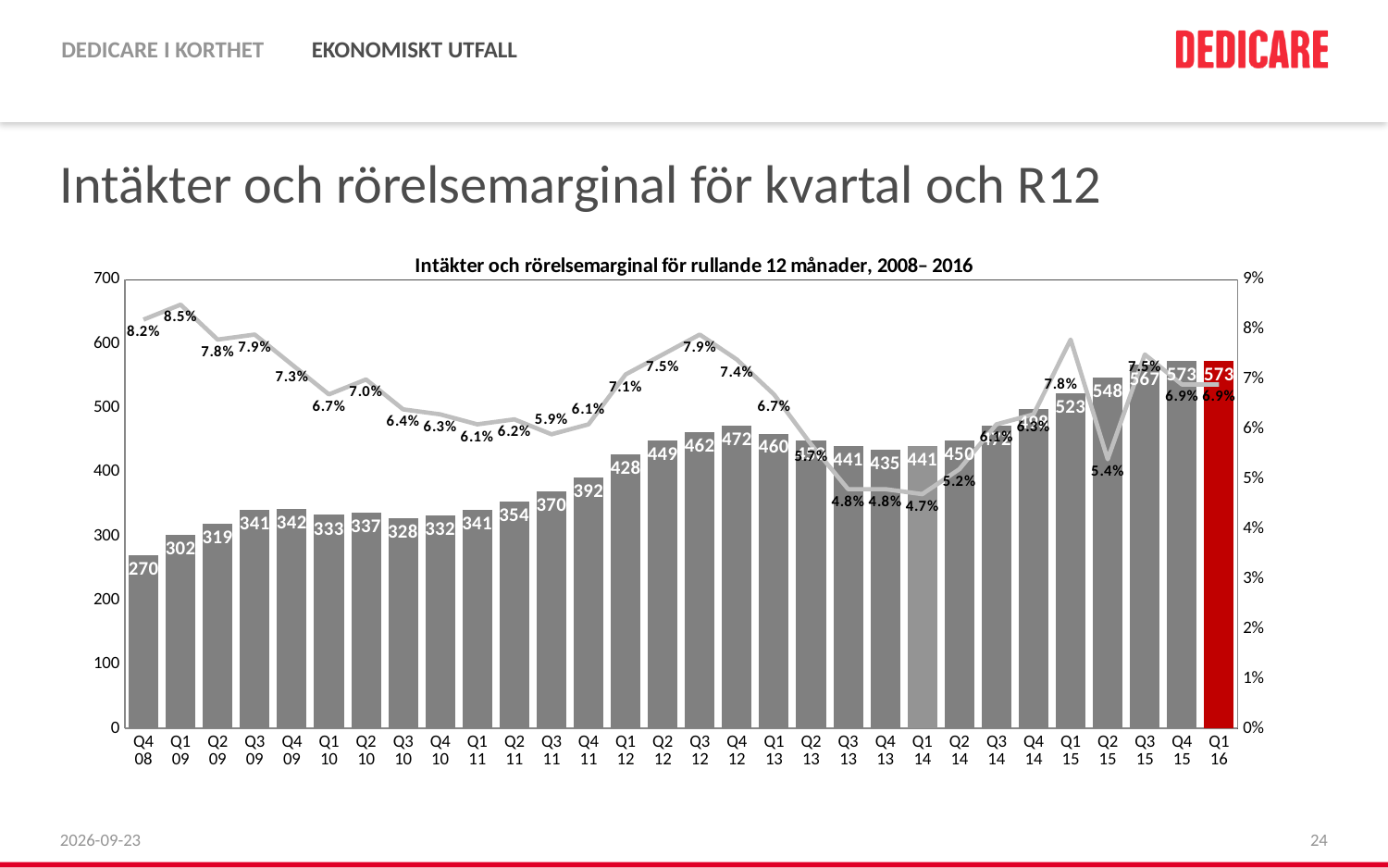
What operating margin is shown for Q1 09? 8.5% What is the title of the chart? Intäkter och rörelsemarginal för rullande 12 månader, 2008– 2016 What operating margin is shown for Q3 12? 7.9% Which quarter has the highest operating margin on the line? Q1 09 Which quarter has the lowest revenue bar? Q4 08 Is the revenue bar for Q2 13 greater or less than 400? greater Which quarter has the lowest operating margin on the line? Q1 14 What is the revenue value shown for Q1 16? 573 What is the revenue value shown for Q4 08? 270 Which has the higher revenue, Q1 12 or Q4 12? Q4 12 What is the difference between the revenue for Q1 16 and the revenue for Q4 08? 303 How many quarters are shown on the x axis? 30